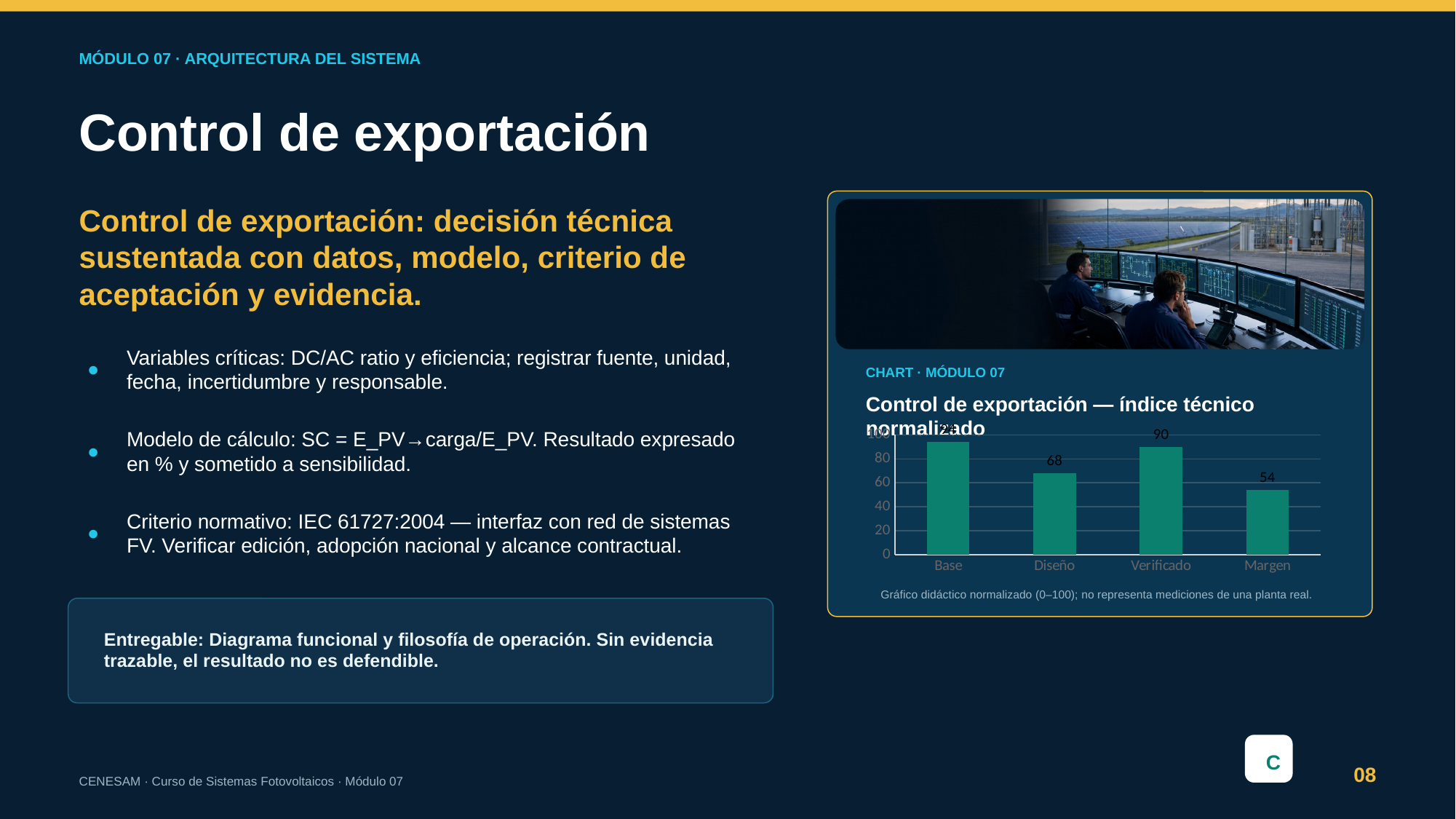
What is the value for Diseño in the chart? 68 Is the value for Margen greater or less than 60? less What type of chart is shown on the slide? bar chart What is the value for Margen in the chart? 54 What is the value for Verificado in the chart? 90 Which is larger, the value for Diseño or the value for Verificado? Verificado Which category has the lowest value in the chart? Margen How many categories are shown on the x axis of the chart? 4 What is the difference between the values for Verificado and Diseño? 22 What is the title of the chart? Control de exportación — índice técnico normalizado Is the value for Base greater or less than 80? greater What is the difference between the values for Diseño and Margen? 14